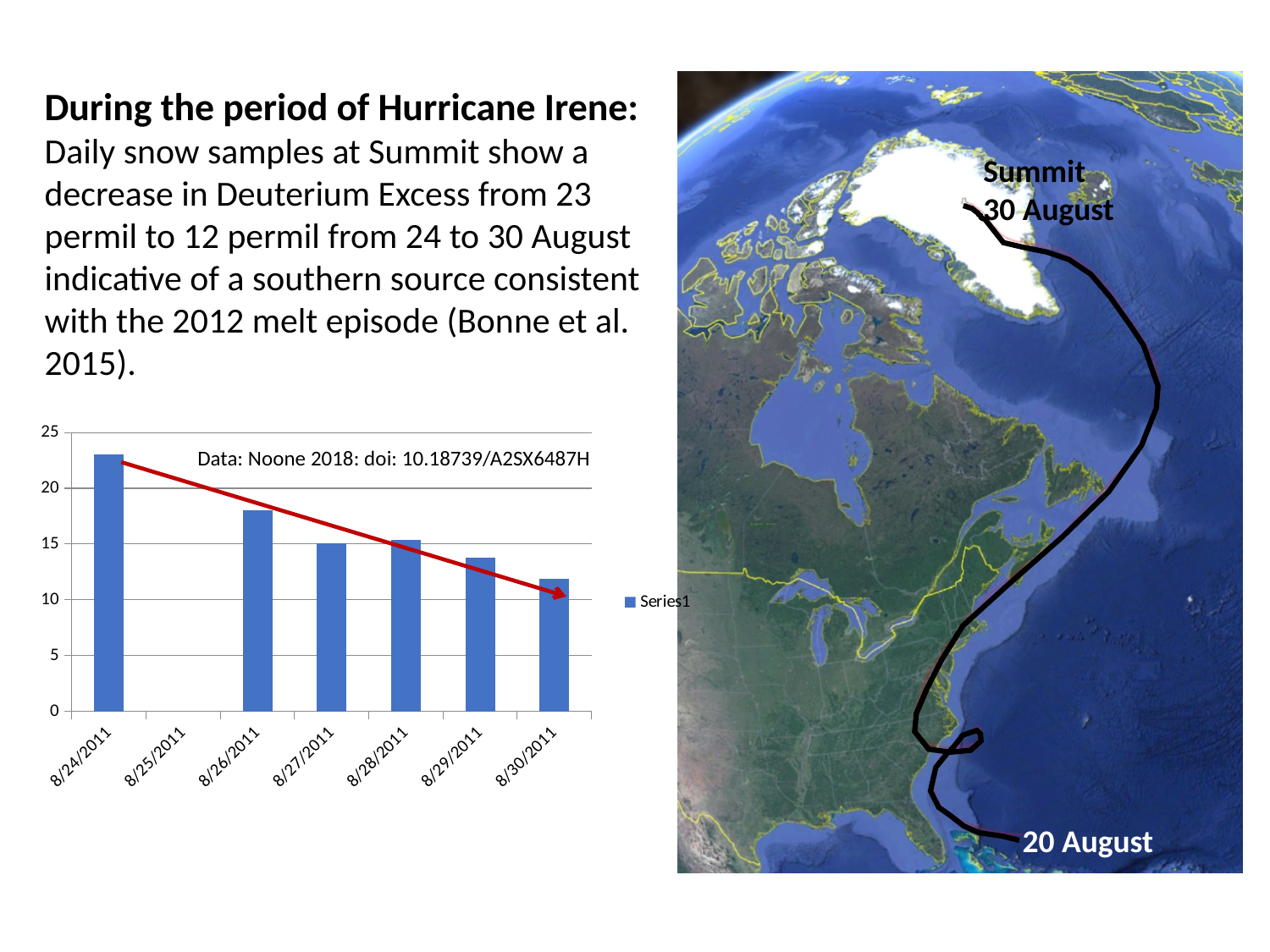
Is the value for 8/26/2011 greater or less than 20? less Is the value for 8/29/2011 greater or less than 15? less Which date has the shortest bar in the chart? 8/30/2011 How many bars are plotted in the chart? 6 Do the bar values generally rise or fall from 8/24/2011 to 8/30/2011? fall How many dates are labelled on the x axis of the chart? 7 Which is larger, the value for 8/26/2011 or the value for 8/30/2011? 8/26/2011 Which date has the tallest bar in the chart? 8/24/2011 Is the value for 8/30/2011 greater or less than 10? greater How many series does the chart legend list? 1 What kind of chart is shown on the slide? bar chart